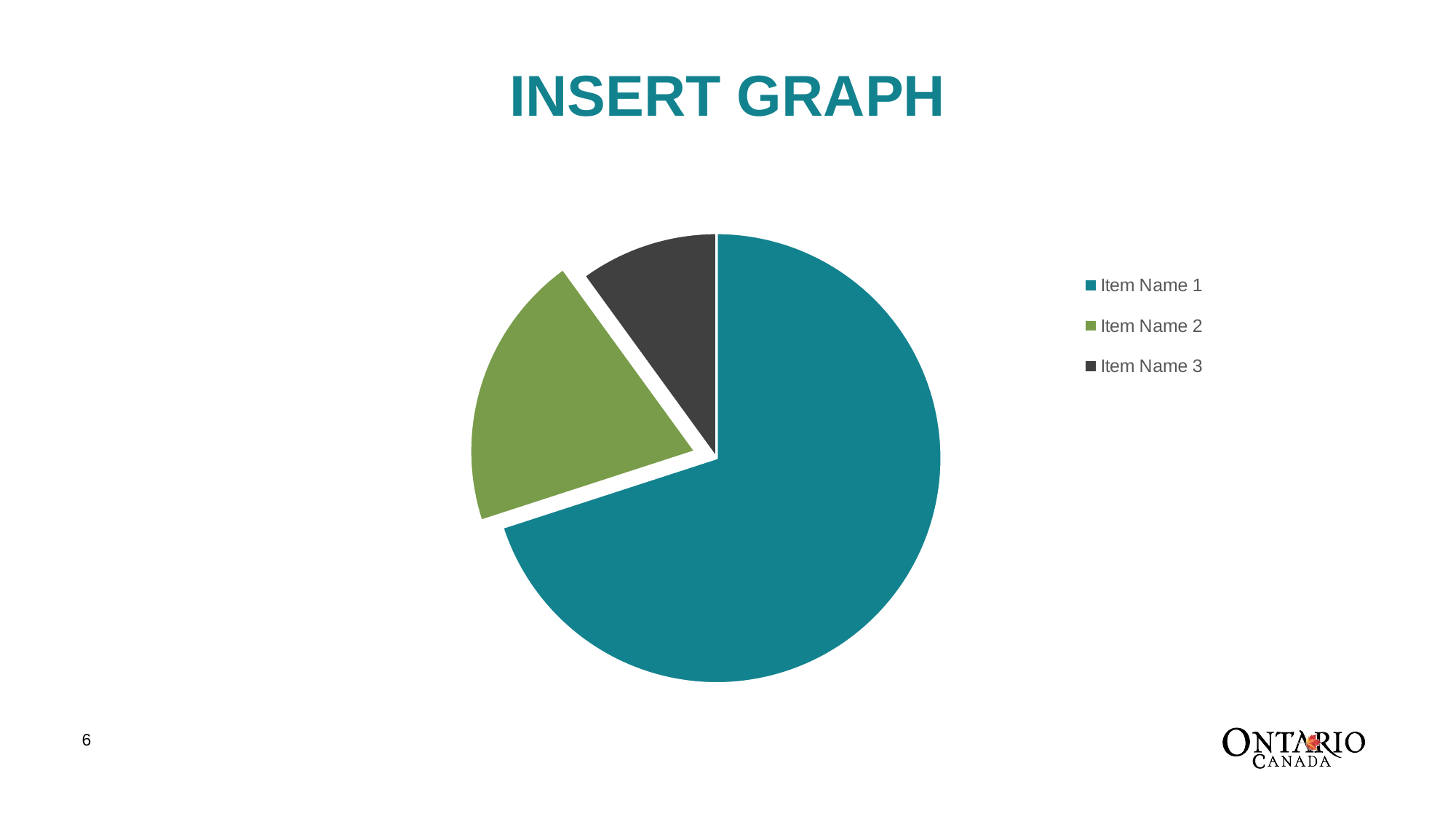
Which item has the largest slice of the pie chart? Item Name 1 What colour is the slice for Item Name 2 in the pie chart? green How many slices does the pie chart have? 3 What kind of chart is shown on the slide? pie chart Which slice is larger, Item Name 1 or Item Name 2? Item Name 1 How many entries does the legend of the pie chart list? 3 Which item has the smallest slice of the pie chart? Item Name 3 What is the title of the slide containing the pie chart? INSERT GRAPH Which slice is larger, Item Name 2 or Item Name 3? Item Name 2 Which slice is smaller, Item Name 1 or Item Name 3? Item Name 3